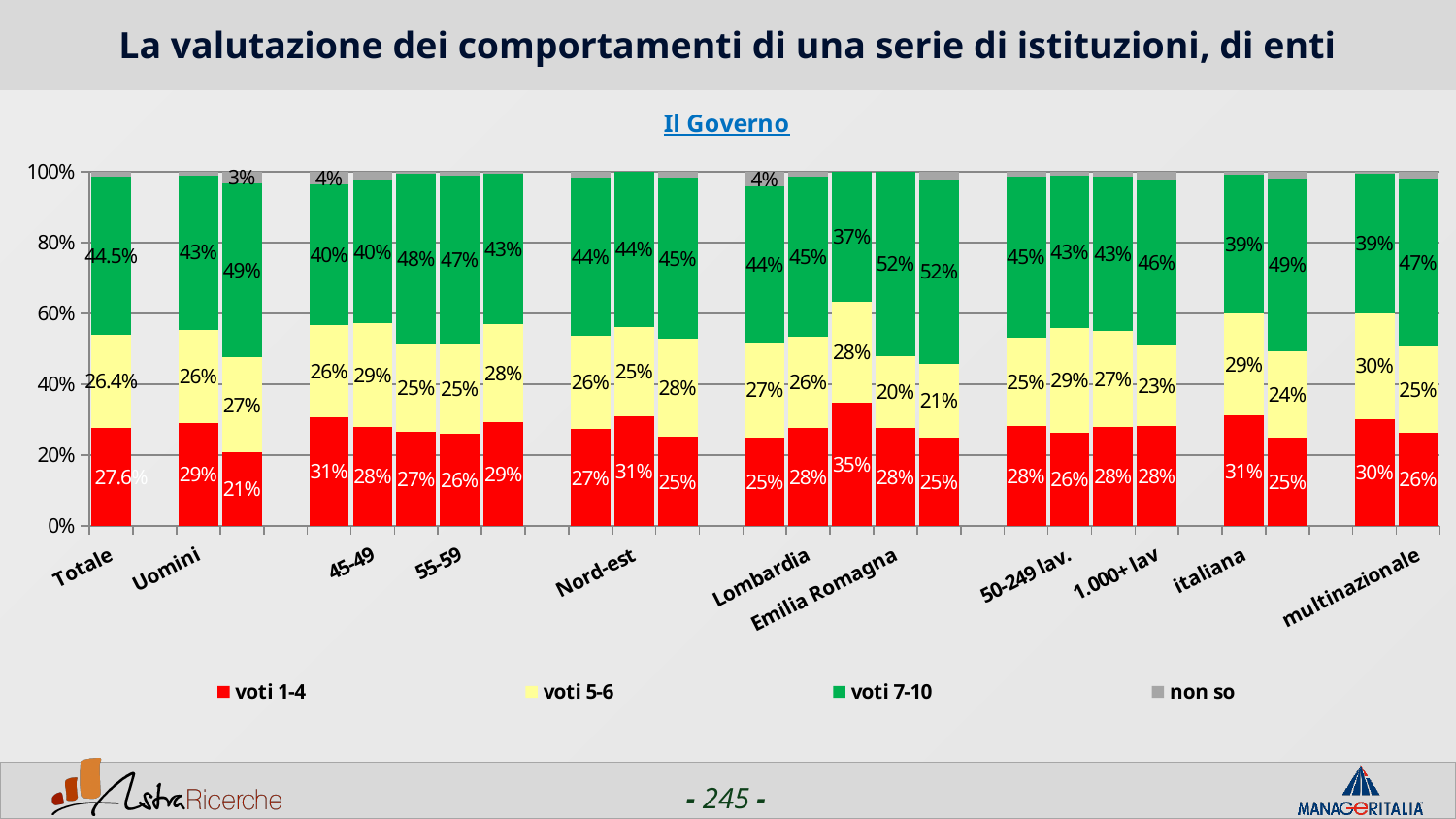
What is the value of 'voti 7-10' for Totale? 44.5% What kind of chart is shown on the slide? stacked bar chart What is the value of 'voti 7-10' for italiana? 39% What is the title of the chart? Il Governo What is the value of 'voti 5-6' for Totale? 26.4% What is the value of 'voti 7-10' for Uomini? 43% How many series does the legend list? 4 For Totale, which is larger: 'voti 7-10' or 'voti 1-4'? voti 7-10 What is the value of 'voti 1-4' for Nord-est? 31% What is the value of 'voti 1-4' for Totale? 27.6% For Emilia Romagna, what is the difference between 'voti 7-10' and 'voti 5-6'? 32 percentage points What is the value of 'voti 7-10' for Emilia Romagna? 52%